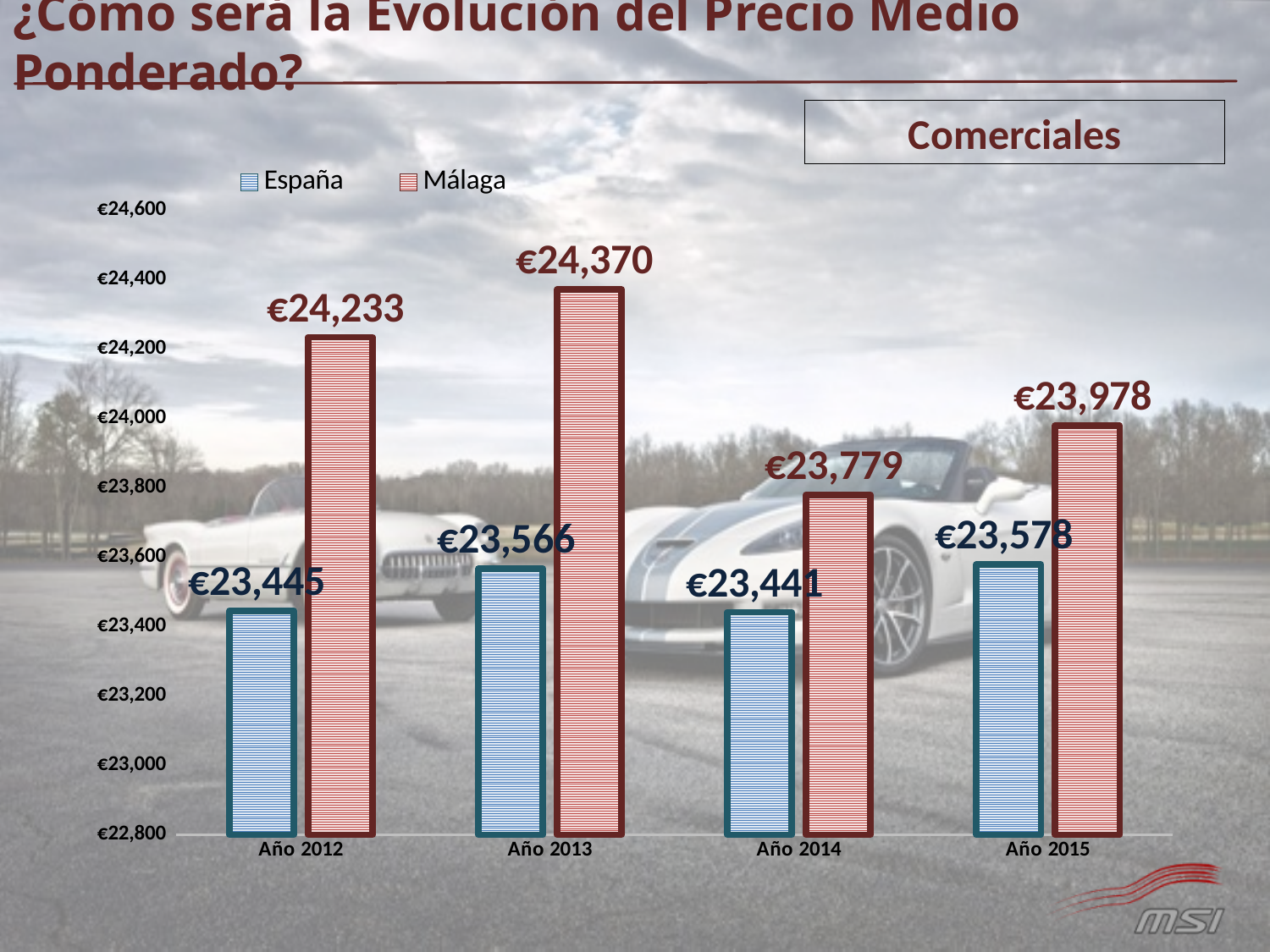
How many series does the legend list? 2 What is the difference between the Málaga values in Año 2013 and Año 2014? €591 What is the difference between the Málaga and España values in Año 2012? €788 In which year is the Málaga value highest? Año 2013 In which year is the Málaga value lowest? Año 2014 How many years are shown on the x axis? 4 Which is larger in Año 2015, the España value or the Málaga value? Málaga Is the Málaga value for Año 2012 greater or less than €24,000? greater What is the value for Málaga in Año 2013? €24,370 What kind of chart is shown on the slide? bar chart What is the value for Málaga in Año 2014? €23,779 What is the value for España in Año 2015? €23,578